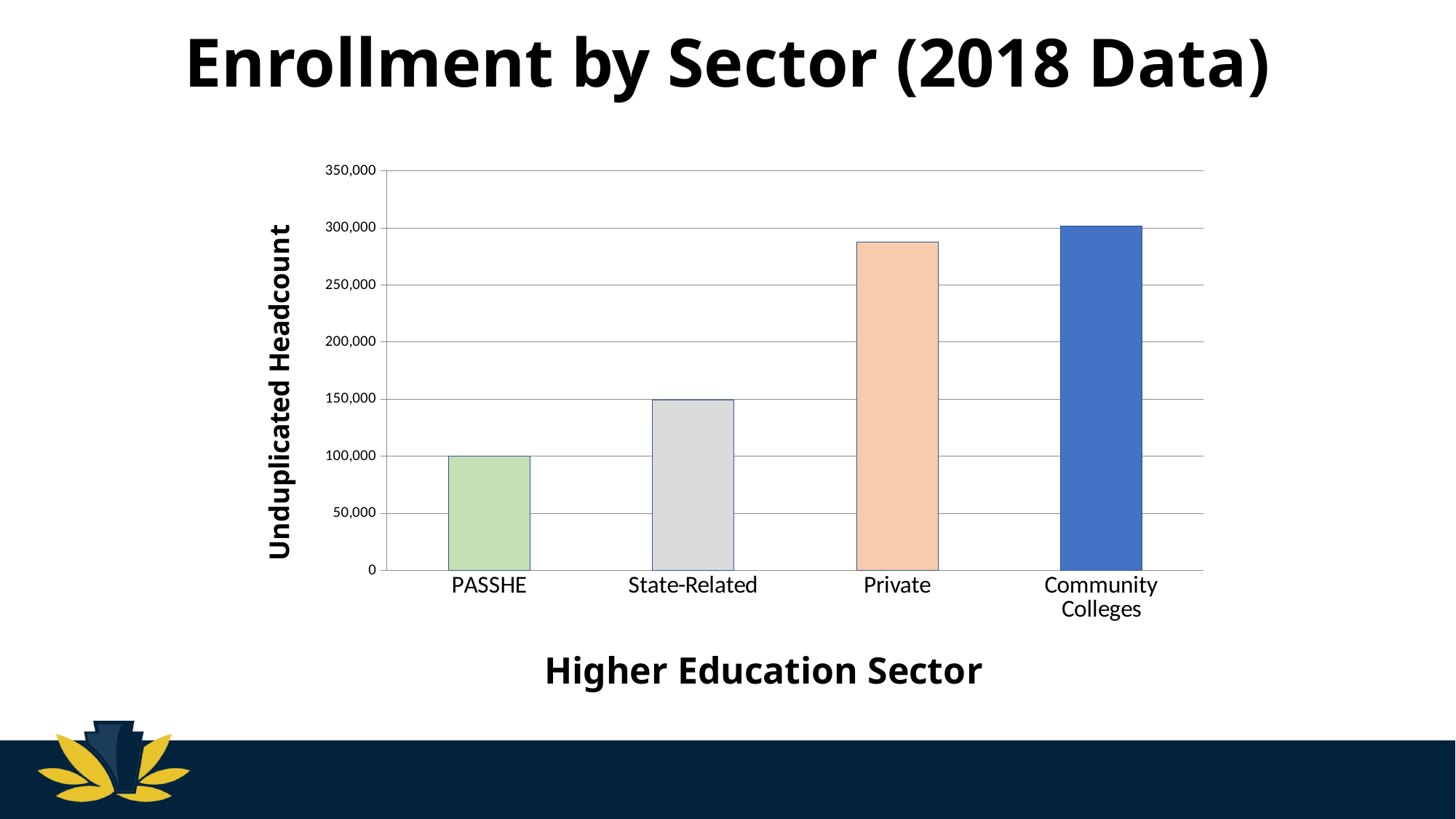
Is the value for Private greater or less than 250,000? greater Which sector has the lowest unduplicated headcount? PASSHE Do the values rise or fall moving from PASSHE to Community Colleges along the x axis? Rise What is the title of the chart? Enrollment by Sector (2018 Data) Is the value for State-Related greater or less than 200,000? less What is the label on the vertical axis of the chart? Unduplicated Headcount Which has a larger unduplicated headcount, State-Related or Private? Private How many sectors are plotted in the chart? 4 What kind of chart is shown on the slide? Bar chart Is the value for Community Colleges greater or less than 250,000? greater Which sector has the highest unduplicated headcount? Community Colleges